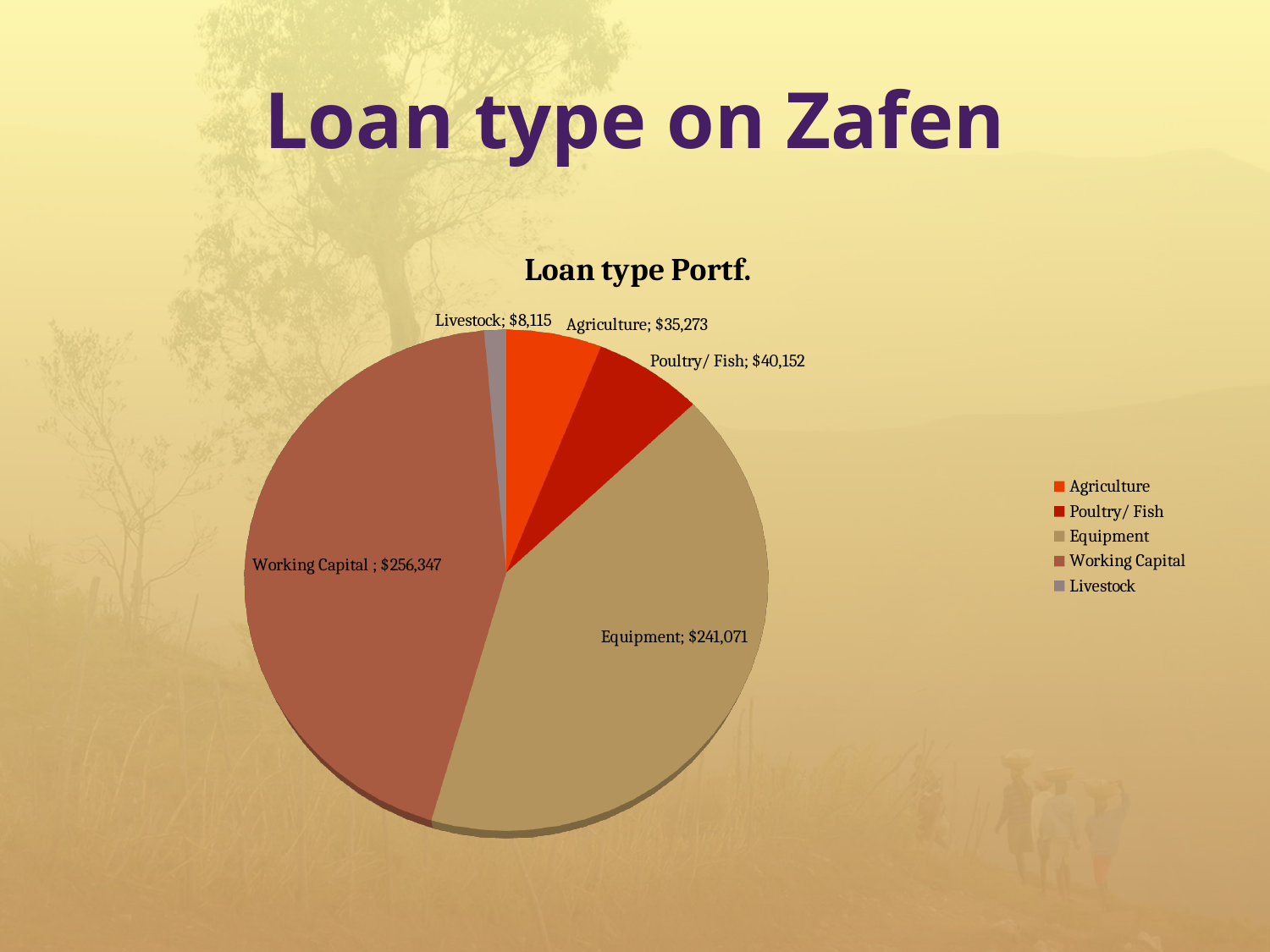
Which is larger, Agriculture or Poultry/ Fish? Poultry/ Fish What is the value for Poultry/ Fish? $40,152 How many loan types are shown in the pie chart? 5 How many entries does the legend list? 5 Which loan type has the smallest value? Livestock Which loan type has the largest value? Working Capital What is the value for Working Capital? $256,347 What type of chart is shown on the slide? Pie chart What is the value for Livestock? $8,115 What is the title of the chart? Loan type Portf. What is the value for Equipment? $241,071 What is the difference between Working Capital and Equipment? $15,276